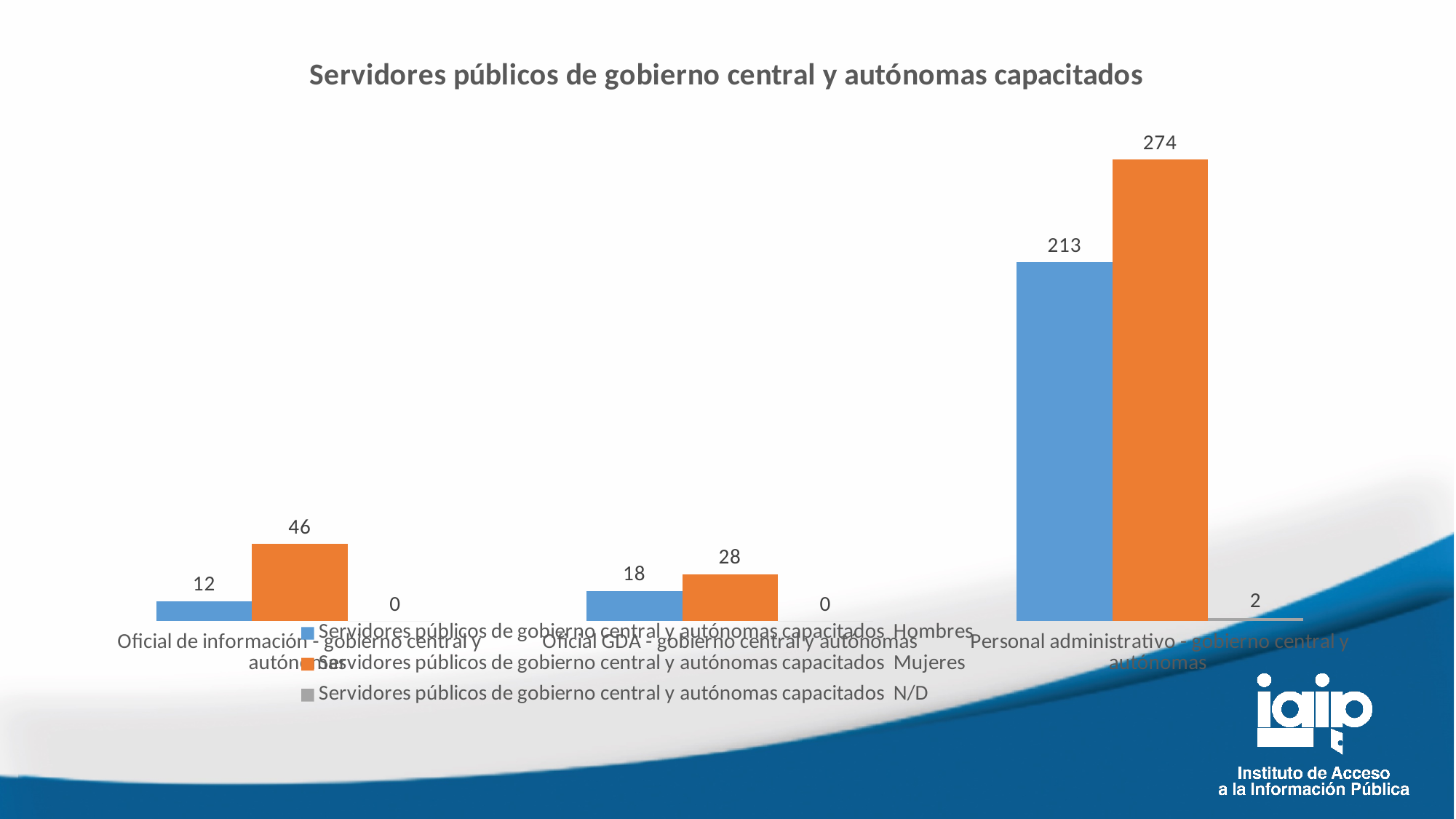
What is the value for N/D in the Personal administrativo category? 2 How many categories are shown on the x axis? 3 What is the difference between Mujeres and Hombres in the Personal administrativo category? 61 Which category has the highest value for Hombres? Personal administrativo - gobierno central y autónomas What is the value for Mujeres in the Personal administrativo category? 274 What is the title of the chart? Servidores públicos de gobierno central y autónomas capacitados What is the value for Hombres in the Oficial GDA category? 18 What is the value for Mujeres in the Oficial de información category? 46 Which is larger in the Oficial de información category, Hombres or Mujeres? Mujeres How many series does the legend list? 3 Which category has the lowest value for Mujeres? Oficial GDA - gobierno central y autónomas What kind of chart is shown on the slide? Bar chart